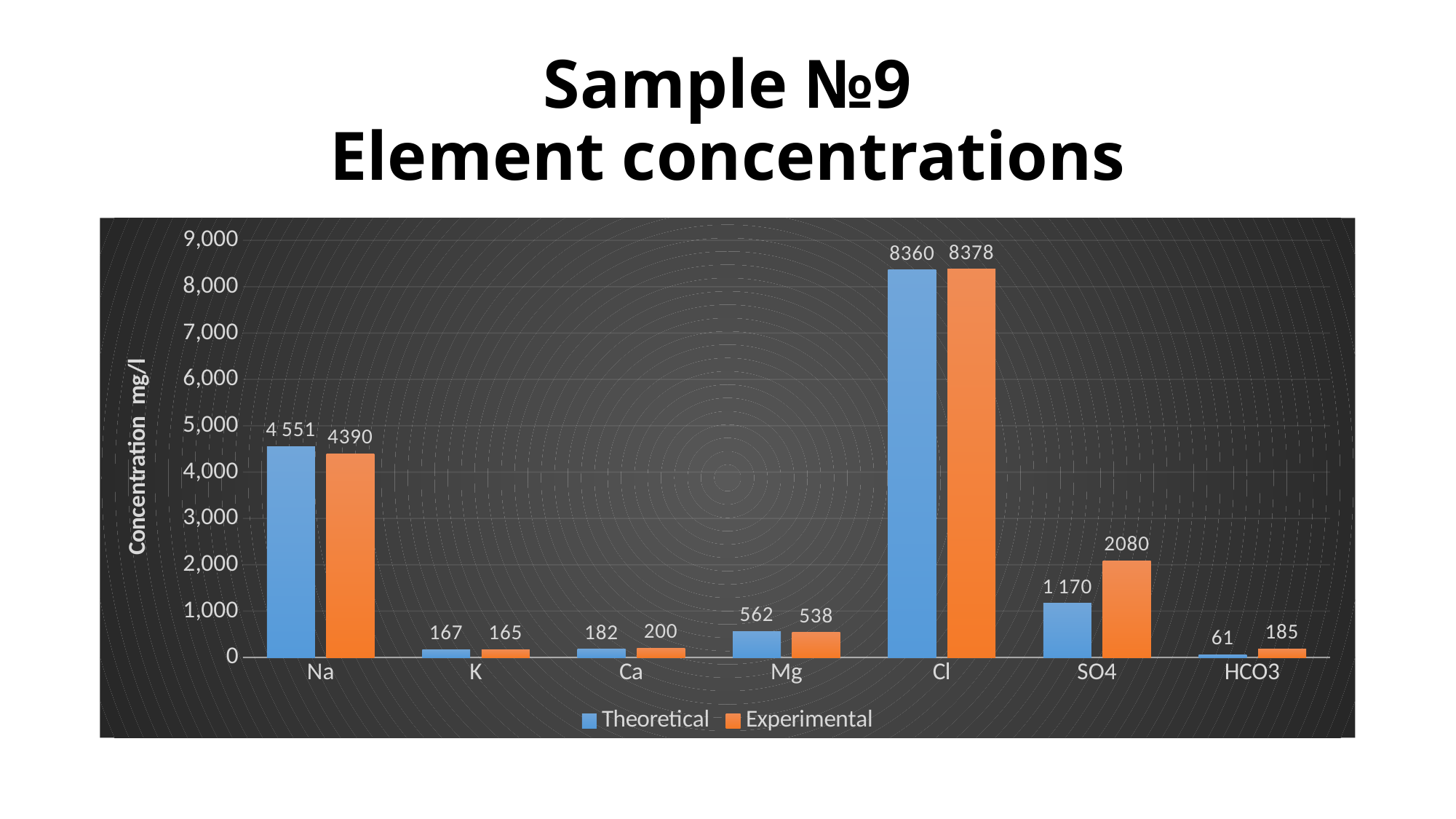
What is the difference between the Experimental and Theoretical concentrations for SO4? 910 How many series does the legend list? 2 How many elements are shown on the x axis? 7 Which element has the highest Theoretical concentration? Cl Which element has the lowest Experimental concentration? K Is the Experimental value for Cl greater or less than 8,000? greater What kind of chart is shown on the slide? Bar chart What is the Experimental concentration for SO4? 2080 For Na, which is larger: the Theoretical or the Experimental concentration? Theoretical What is the Experimental concentration for HCO3? 185 What is the difference between the Theoretical and Experimental concentrations for Mg? 24 What is the Theoretical concentration for Na? 4 551